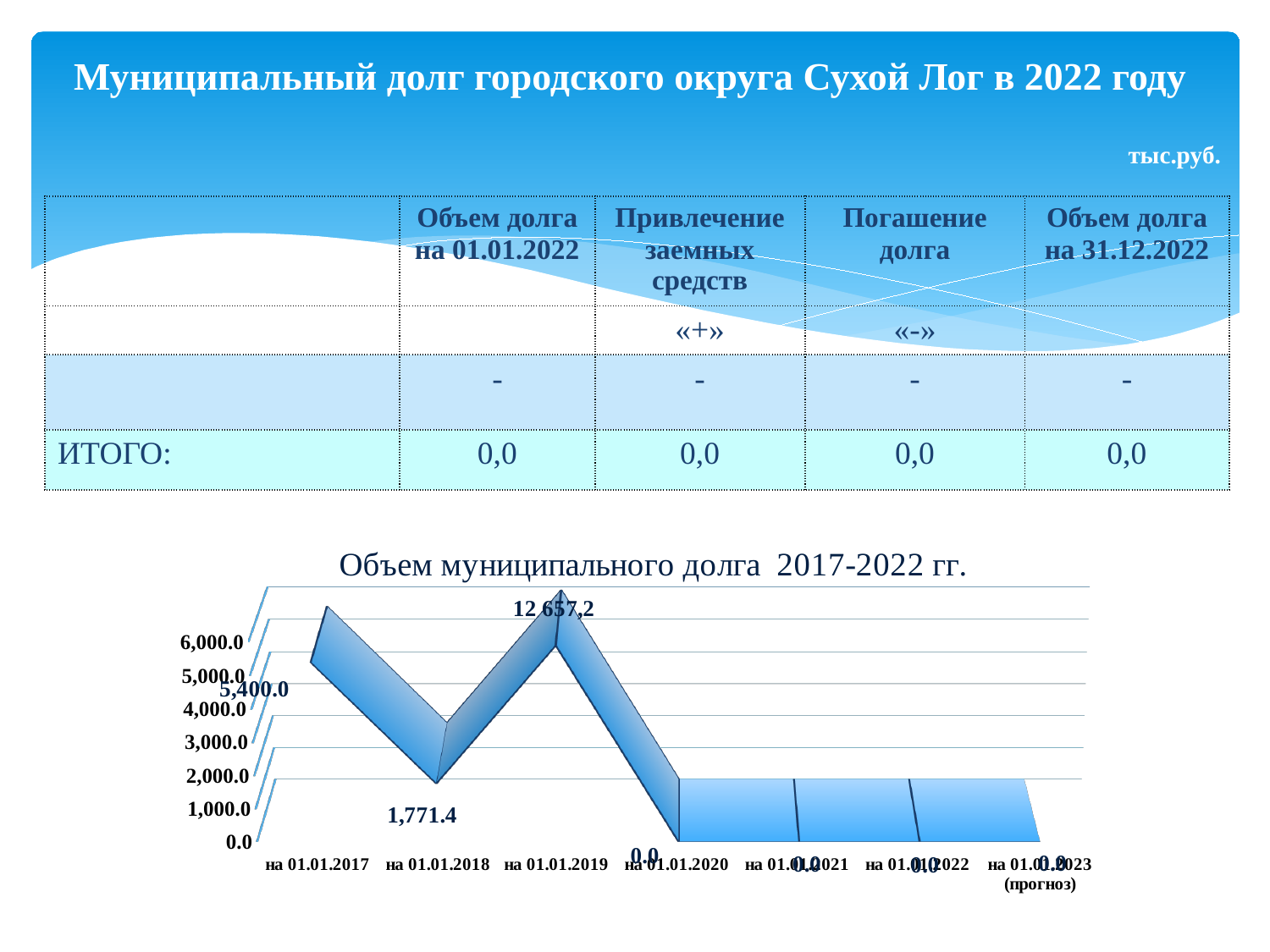
Does the value rise or fall from на 01.01.2017 to на 01.01.2018 in the chart? fall What is the value for на 01.01.2019 in the chart? 12 657,2 What is the value for на 01.01.2020 in the chart? 0.0 Which date has the highest value in the chart? на 01.01.2019 What is the value for на 01.01.2017 in the chart? 5,400.0 How many data points are plotted in the chart? 7 Which is larger in the chart, the value for на 01.01.2017 or the value for на 01.01.2018? на 01.01.2017 What is the value for на 01.01.2023 (прогноз) in the chart? 0.0 What is the title of the chart on the slide? Объем муниципального долга 2017-2022 гг. What is the value for на 01.01.2018 in the chart? 1,771.4 What is the difference between the values for на 01.01.2017 and на 01.01.2018 in the chart? 3,628.6 What kind of chart is shown on the slide? line chart